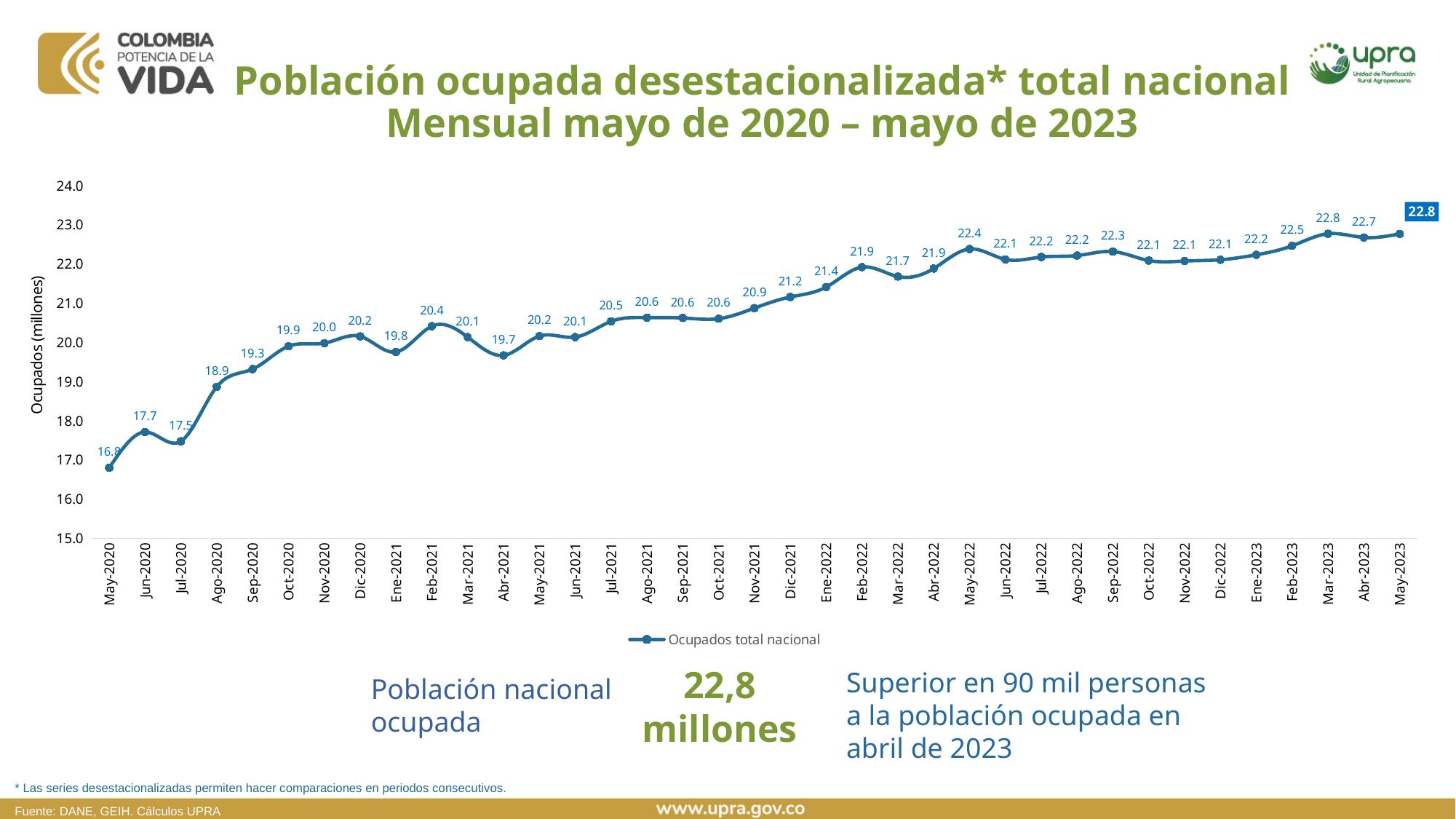
Which month has the lowest value? May-2020 Is the value for Sep-2020 greater or less than 20.0? less What is the value for Ene-2021? 19.8 What is the value for Abr-2023? 22.7 Which is larger, the value for Feb-2021 or the value for Abr-2021? Feb-2021 What kind of chart is shown? line chart What is the value for Feb-2022? 21.9 How many monthly data points are plotted? 37 What is the difference between the values for Ago-2020 and Jul-2020? 1.4 What is the difference between the values for May-2023 and May-2020? 6.0 What is the value for May-2020? 16.8 What is the label of the y axis? Ocupados (millones)